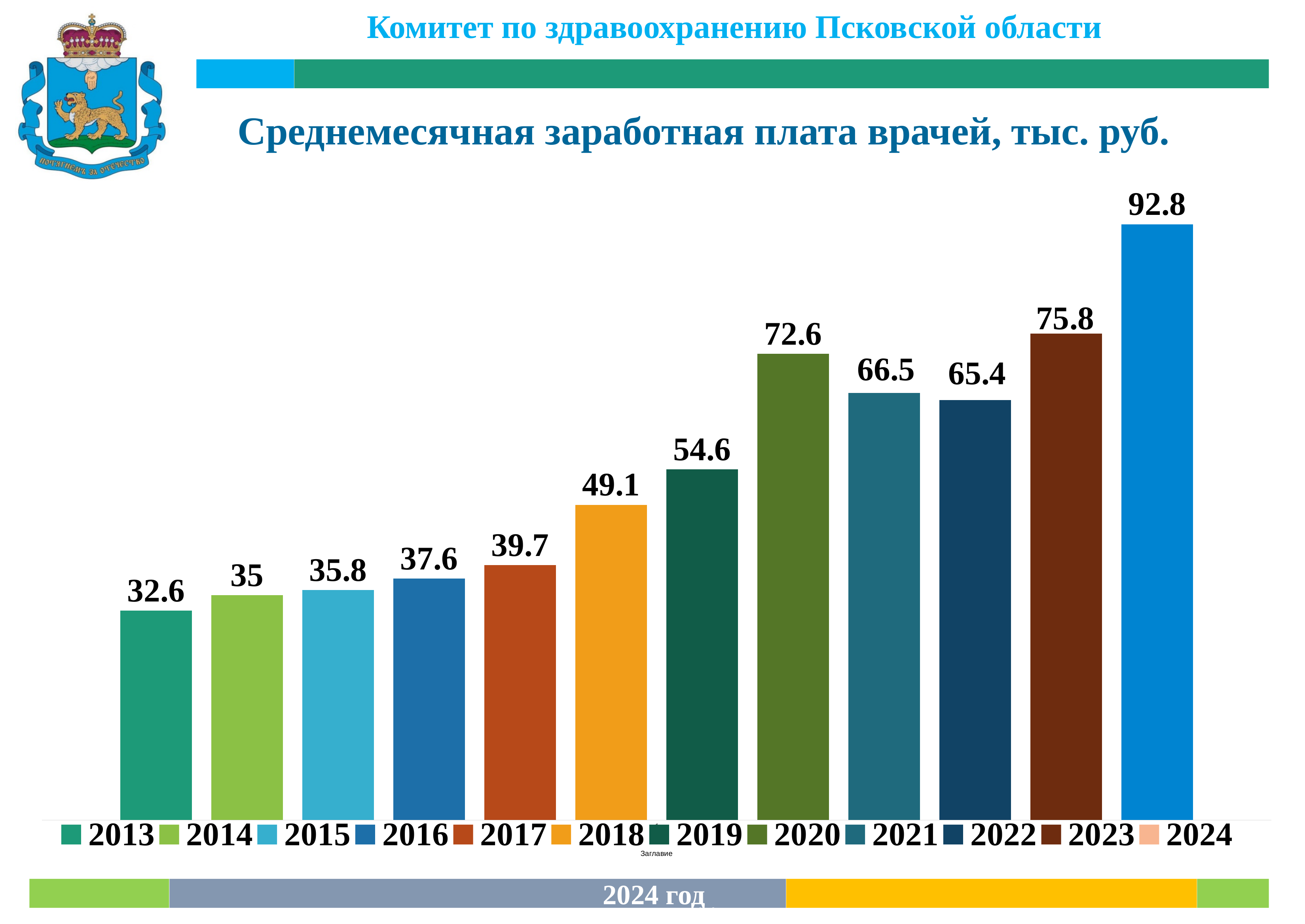
What is the value for 2018? 49.1 What is the title of the chart? Среднемесячная заработная плата врачей, тыс. руб. What kind of chart is shown on the slide? bar chart Which year has the lowest value? 2013 What is the value for 2020? 72.6 What is the value for 2013? 32.6 Which is larger, the value for 2020 or the value for 2021? 2020 What is the difference between the values for 2020 and 2019? 18 How many bars are shown in the chart? 12 Do the values generally rise or fall from 2013 to 2024? rise Which year has the highest value? 2024 What is the difference between the values for 2024 and 2023? 17